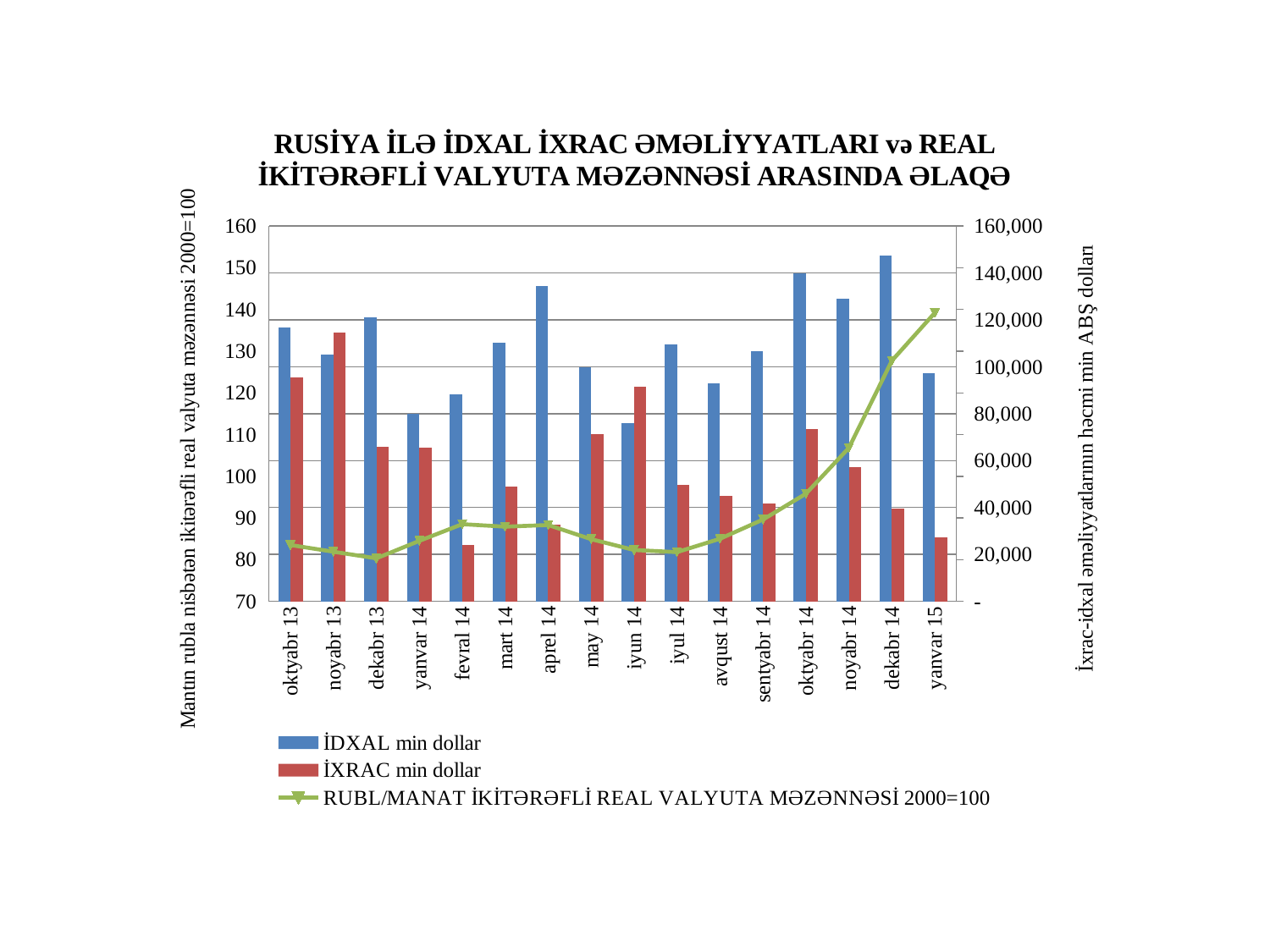
What kind of chart is shown on the slide? A combination bar and line chart How many months are shown along the x axis? 16 Is the İDXAL min dollar value for dekabr 14 greater or less than 140,000? greater Is the İXRAC min dollar value for fevral 14 greater or less than 40,000? less In which month is the İDXAL min dollar bar the highest? dekabr 14 In oktyabr 14, which is larger: İDXAL min dollar or İXRAC min dollar? İDXAL min dollar Does the RUBL/MANAT real exchange rate line rise or fall from sentyabr 14 to yanvar 15? It rises What colour are the İXRAC min dollar bars? Red Is the RUBL/MANAT real exchange rate value for yanvar 15 greater or less than 130? greater In which month is the İXRAC min dollar bar the highest? noyabr 13 In which month does the RUBL/MANAT real exchange rate line reach its highest point? yanvar 15 How many series does the legend list? 3